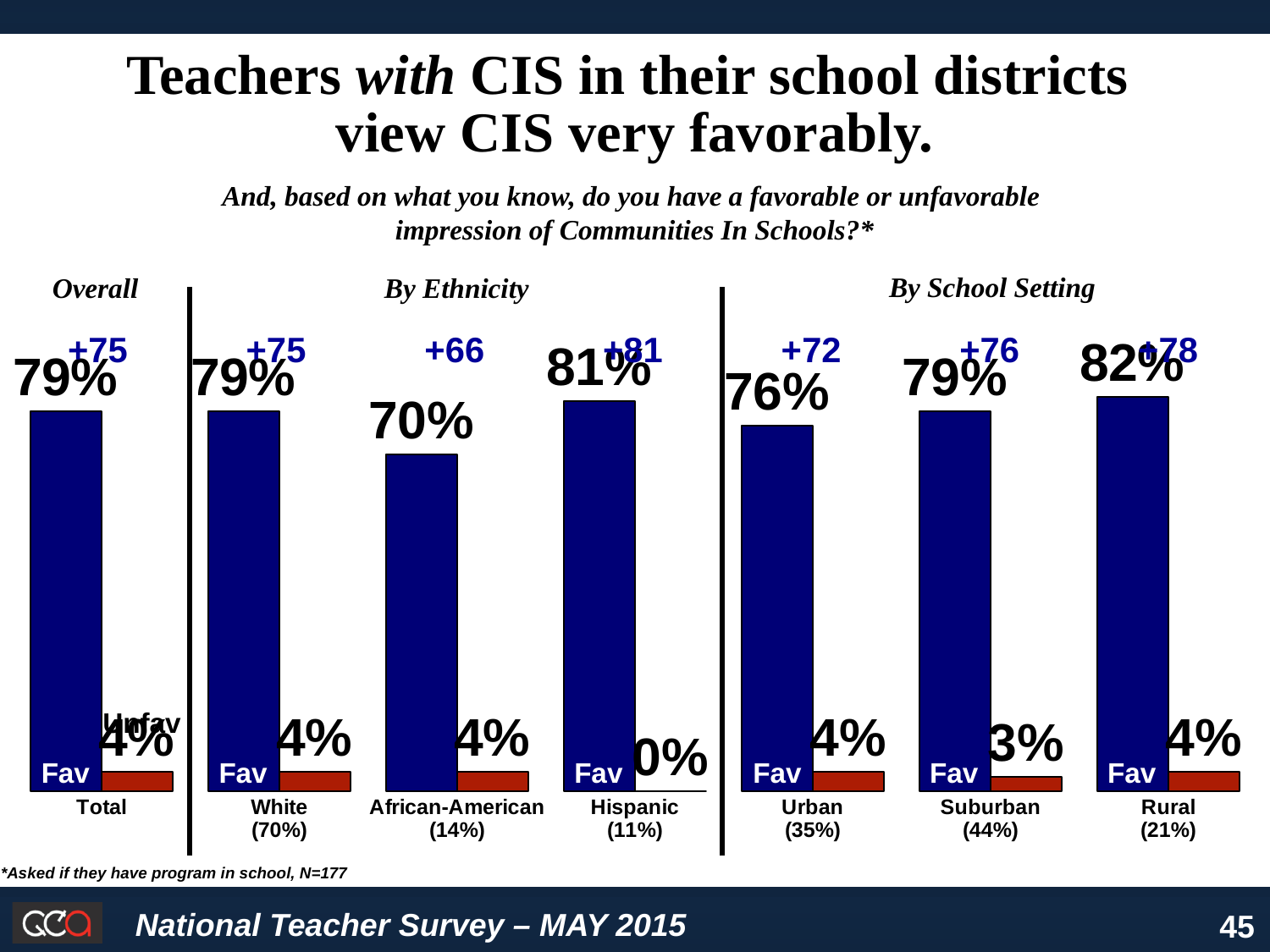
In the By Ethnicity chart, what is the unfavorable percentage for Hispanic teachers? 0% In the By School Setting chart, what is the difference between the Rural and Urban favorable percentages? 6% In the By Ethnicity chart, is the favorable percentage for White teachers larger or smaller than for Hispanic teachers? smaller In the By School Setting chart, what is the unfavorable percentage for Suburban teachers? 3% In the By School Setting chart, what is the favorable percentage for Rural teachers? 82% In the By School Setting chart, which setting has the lowest favorable percentage? Urban In the Overall chart, what is the favorable percentage for Total? 79% In the By Ethnicity chart, which group has the highest favorable percentage? Hispanic In the By Ethnicity chart, what is the favorable percentage for African-American teachers? 70% What kind of chart is used on this slide? bar chart In the By Ethnicity chart, which group has the lowest favorable percentage? African-American In the Overall chart, what is the unfavorable percentage for Total? 4%